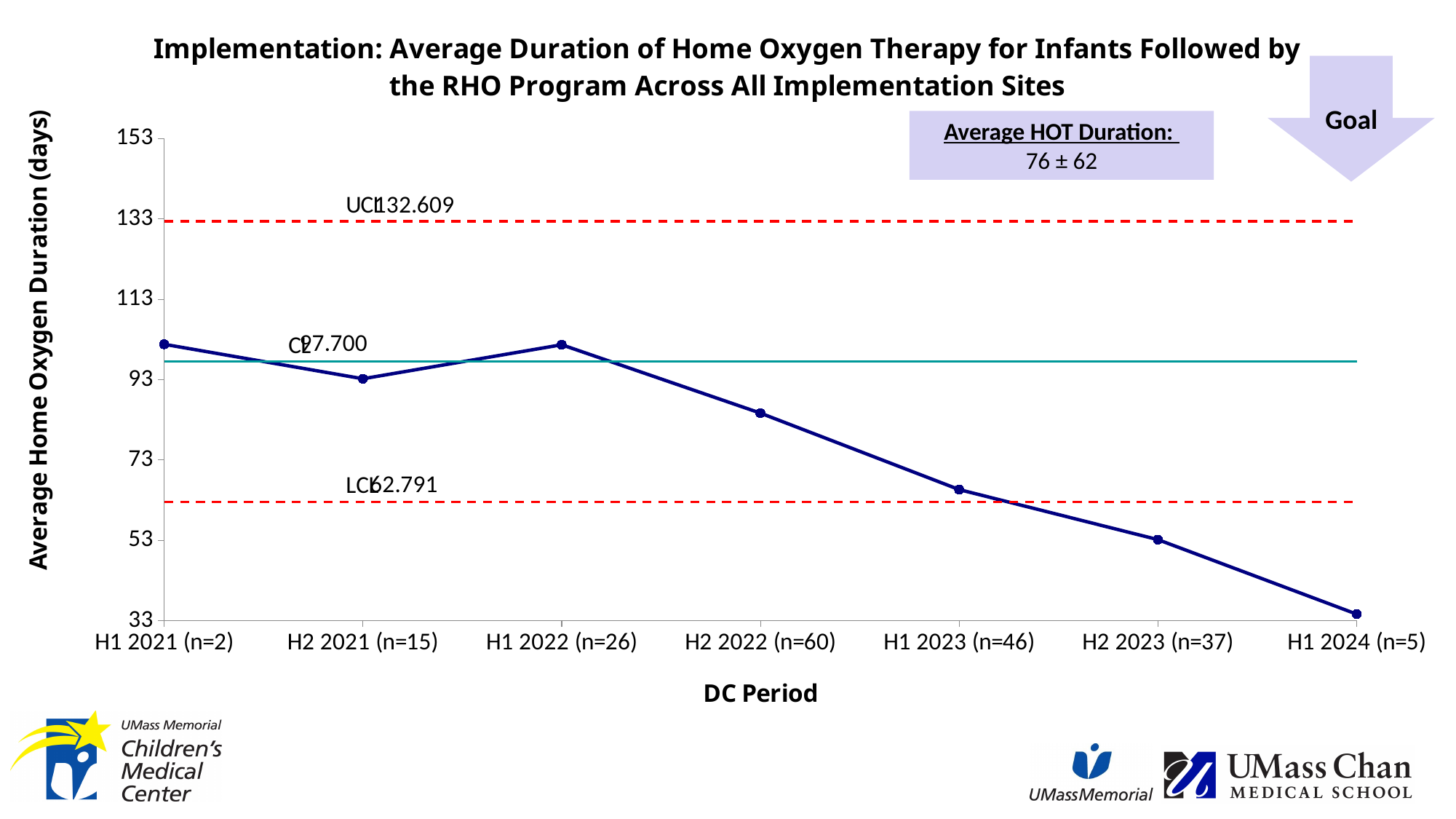
Is the value for H1 2021 (n=2) greater or less than 93? greater Is the value for H1 2024 (n=5) greater or less than 53? less What is the label of the y axis? Average Home Oxygen Duration (days) What is the value of the UCL line? 132.609 What is the value of the CL line? 97.700 Is the value for H1 2023 (n=46) greater or less than 73? less How many DC periods are plotted on the x axis? 7 What kind of chart is shown on the slide? line chart Which is larger, the value for H2 2022 (n=60) or the value for H1 2023 (n=46)? H2 2022 (n=60) Which DC period has the lowest average home oxygen duration? H1 2024 (n=5) Do the plotted values rise or fall from H1 2022 to H1 2024? fall What is the value of the LCL line? 62.791